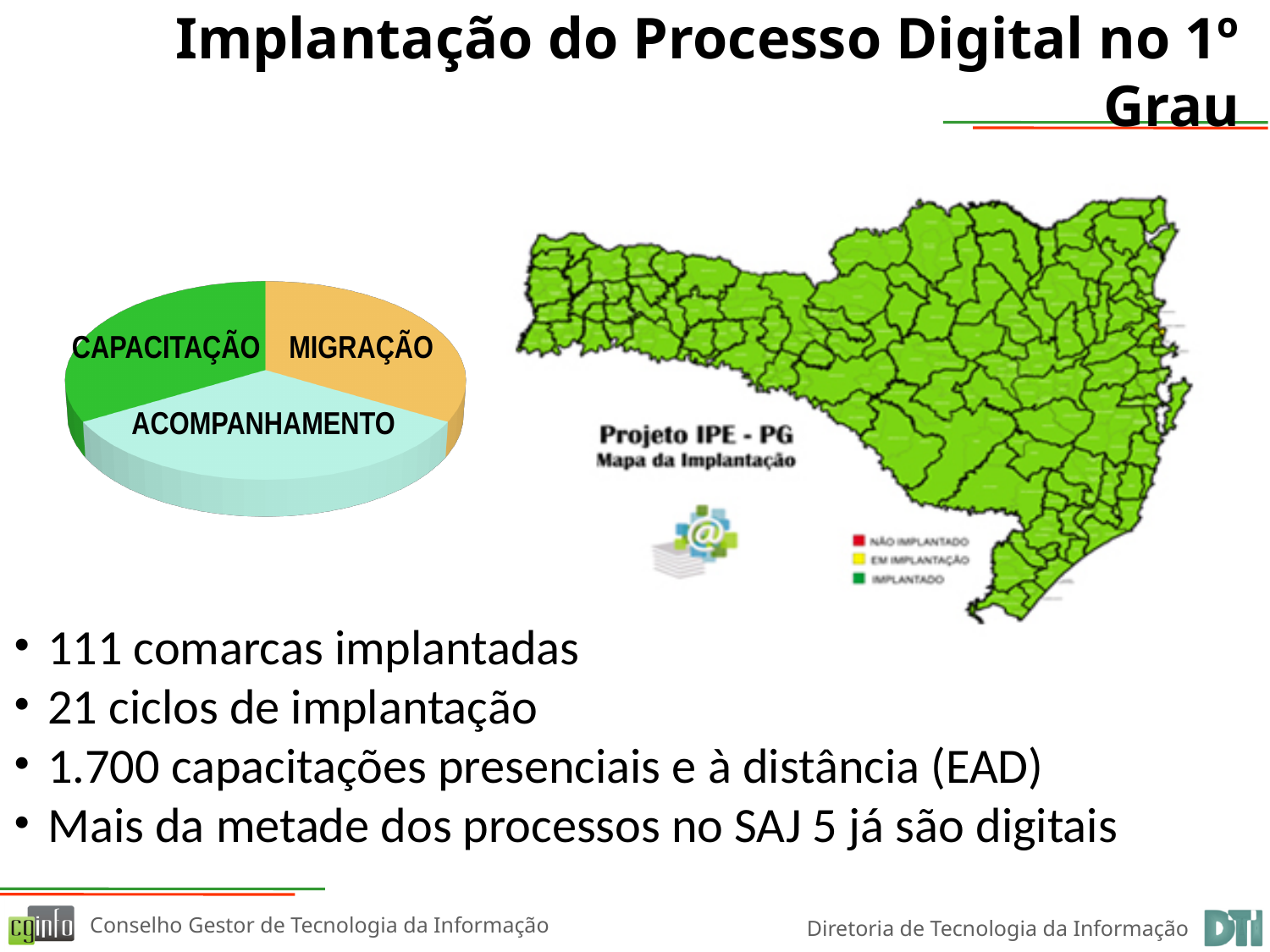
Which slice of the pie chart is coloured green? CAPACITAÇÃO Which slice of the pie chart is labelled at the bottom, in the light blue section? ACOMPANHAMENTO How many slices does the pie chart have? 3 Which slice of the pie chart is coloured orange? MIGRAÇÃO Does the pie chart show any numeric values or percentages on its slices? No What kind of chart is shown on the left of the slide? Pie chart